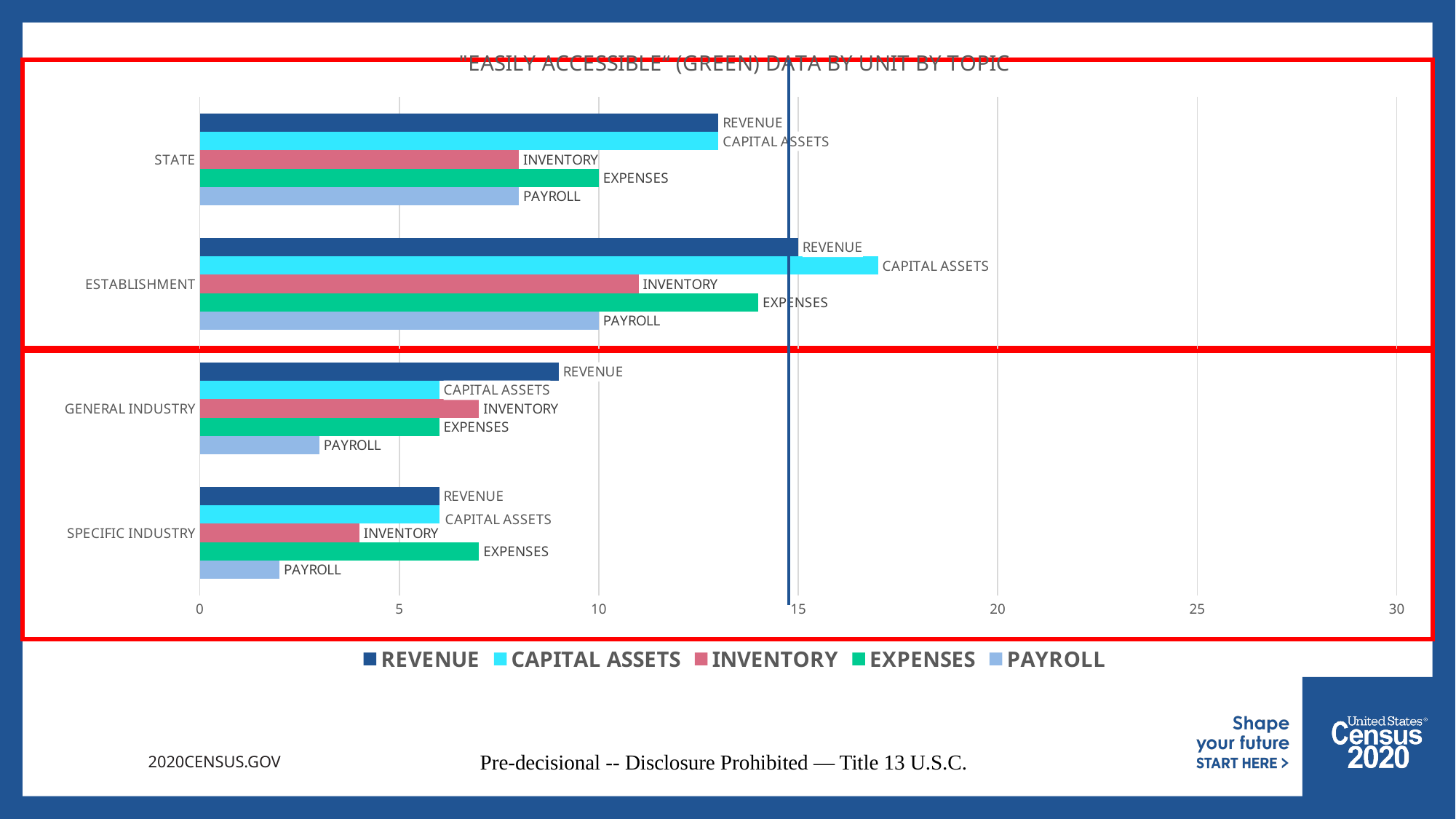
Is the Revenue value for General Industry greater or less than 10? less Is the Capital Assets value for Establishment greater or less than 15? greater Which is larger, the Revenue value for State or the Revenue value for General Industry? State Which category has the longest Capital Assets bar? Establishment How many series does the chart's legend list? 5 What is the Expenses value for State? 10 For Establishment, which is larger, the Inventory value or the Expenses value? Expenses Which series is shown in green in the chart's legend? Expenses What kind of chart is shown on the slide? bar chart How many categories (units) are shown on the vertical axis of the chart? 4 Is the Payroll value for Specific Industry greater or less than 5? less Which category has the shortest Payroll bar? Specific Industry